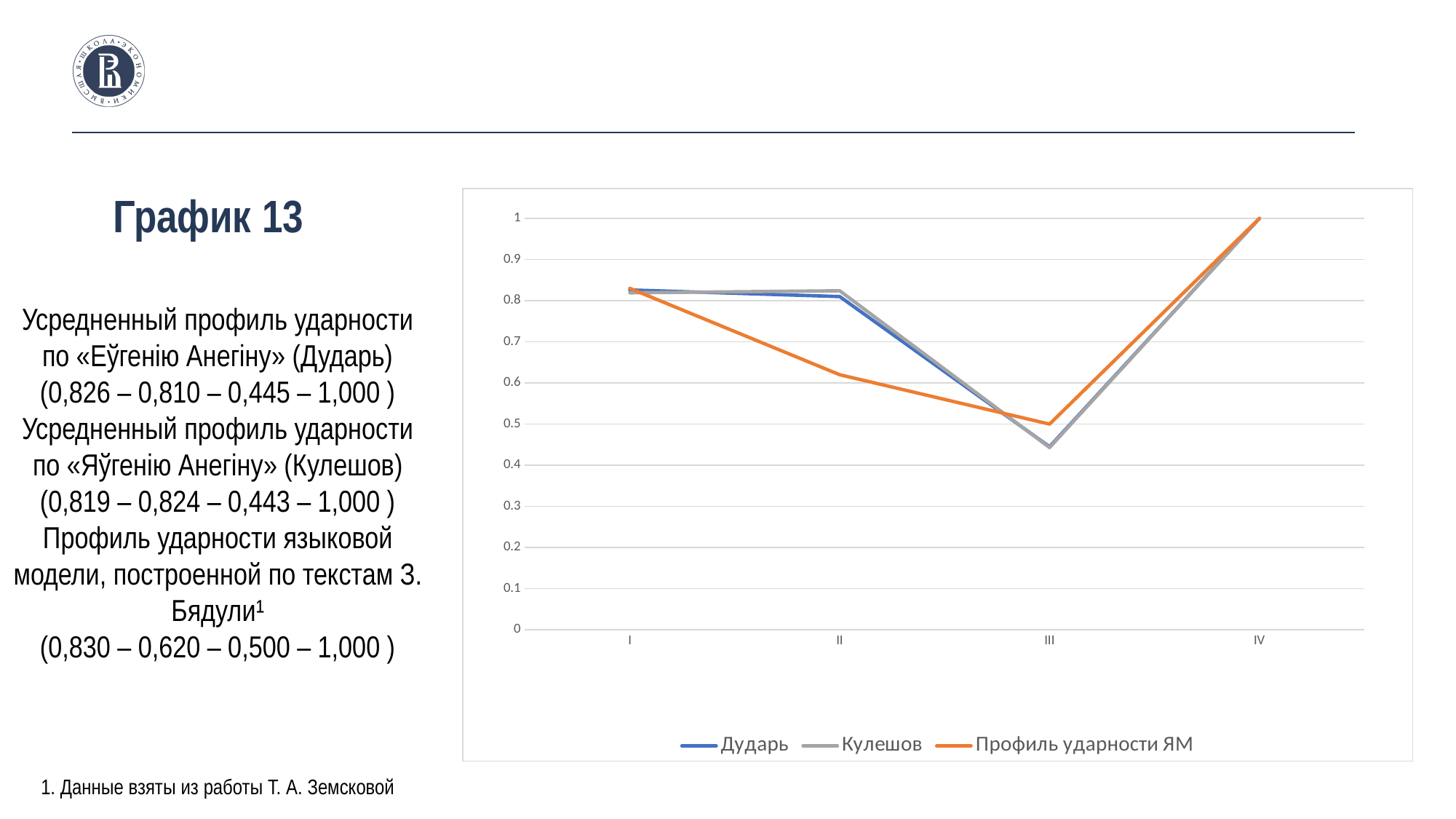
At which point does the Кулешов series reach its lowest value? III What colour is the line for Профиль ударности ЯМ in the chart? orange What is the difference between the Дударь values at point I and point III? 0,381 What is the value of the Дударь series at point III? 0,445 Do the series rise or fall from point III to point IV? rise Is the value of Профиль ударности ЯМ at point III greater or less than 0.6? less How many points are there along the x axis of the chart? 4 What is the value of the Профиль ударности ЯМ series at point II? 0,620 Which series has the highest value at point III? Профиль ударности ЯМ At point II, which series has the larger value: Дударь or Профиль ударности ЯМ? Дударь How many series does the chart legend list? 3 What kind of chart is shown on the slide? line chart